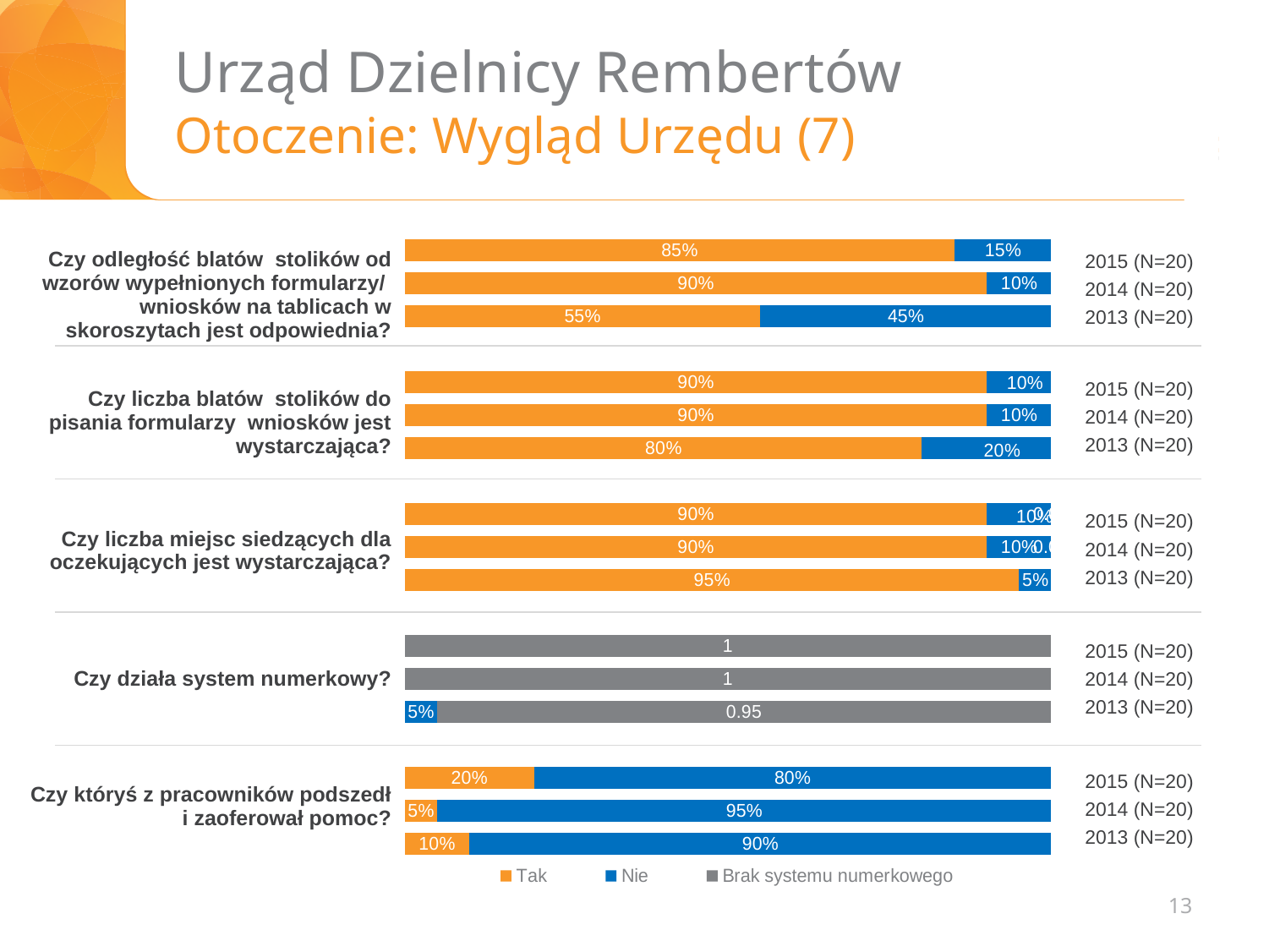
In the chart for "Czy któryś z pracowników podszedł i zaoferował pomoc?", is the "Tak" value for 2015 (N=20) larger or smaller than the "Tak" value for 2013 (N=20)? larger In the chart for "Czy liczba blatów stolików do pisania formularzy wniosków jest wystarczająca?", what is the "Nie" value for 2013 (N=20)? 20% In the chart for "Czy odległość blatów stolików od wzorów wypełnionych formularzy/wniosków na tablicach w skoroszytach jest odpowiednia?", which year has the lowest "Tak" value? 2013 (N=20) In the chart for "Czy liczba blatów stolików do pisania formularzy wniosków jest wystarczająca?", what is the difference between the "Tak" values for 2015 (N=20) and 2013 (N=20)? 10% In the chart for "Czy odległość blatów stolików od wzorów wypełnionych formularzy/wniosków na tablicach w skoroszytach jest odpowiednia?", what is the "Tak" value for 2015 (N=20)? 85% How many series does the legend at the bottom of the slide list? 3 In the chart for "Czy działa system numerkowy?", what is the "Brak systemu numerkowego" value for 2013 (N=20)? 0.95 In the chart for "Czy odległość blatów stolików od wzorów wypełnionych formularzy/wniosków na tablicach w skoroszytach jest odpowiednia?", what is the "Nie" value for 2013 (N=20)? 45% In the chart for "Czy liczba miejsc siedzących dla oczekujących jest wystarczająca?", what is the "Tak" value for 2013 (N=20)? 95% What kind of chart is used for "Czy któryś z pracowników podszedł i zaoferował pomoc?"? Stacked bar chart In the chart for "Czy któryś z pracowników podszedł i zaoferował pomoc?", what is the "Nie" value for 2014 (N=20)? 95% In the chart for "Czy liczba miejsc siedzących dla oczekujących jest wystarczająca?", which year has the highest "Tak" value? 2013 (N=20)